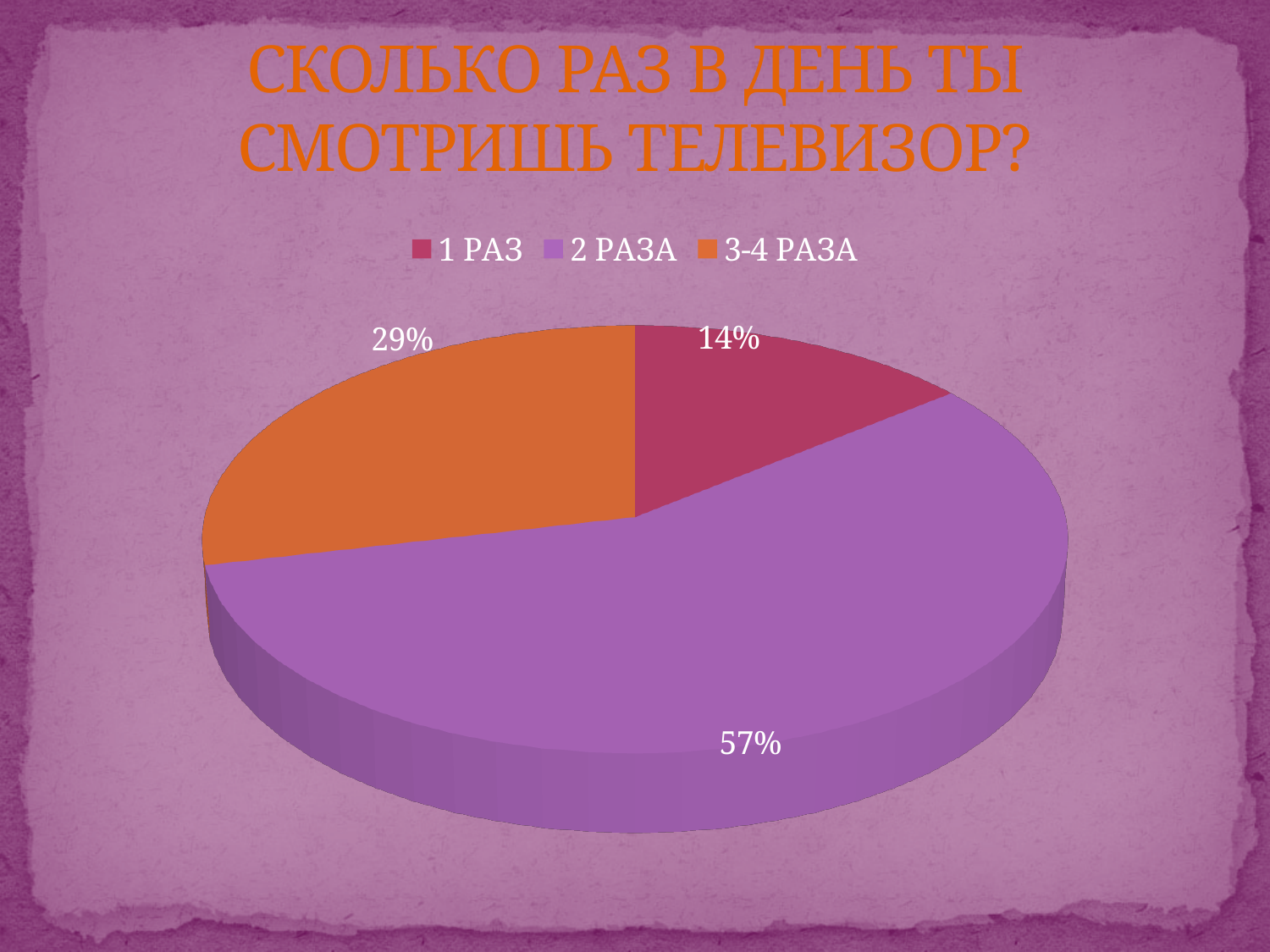
What is the difference between the "3-4 РАЗА" and "1 РАЗ" values? 15% Which is larger, the value for "3-4 РАЗА" or the value for "1 РАЗ"? 3-4 РАЗА What share of the pie does the "2 РАЗА" slice represent? 57% What is the title of the chart? СКОЛЬКО РАЗ В ДЕНЬ ТЫ СМОТРИШЬ ТЕЛЕВИЗОР? What is the value shown for "3-4 РАЗА"? 29% Which category has the largest slice of the pie? 2 РАЗА Which category has the smallest slice of the pie? 1 РАЗ What is the value shown for "1 РАЗ"? 14% What kind of chart is shown on the slide? Pie chart What is the difference between the "2 РАЗА" and "3-4 РАЗА" values? 28% How many categories does the pie chart show? 3 What colour is the "3-4 РАЗА" slice? Orange